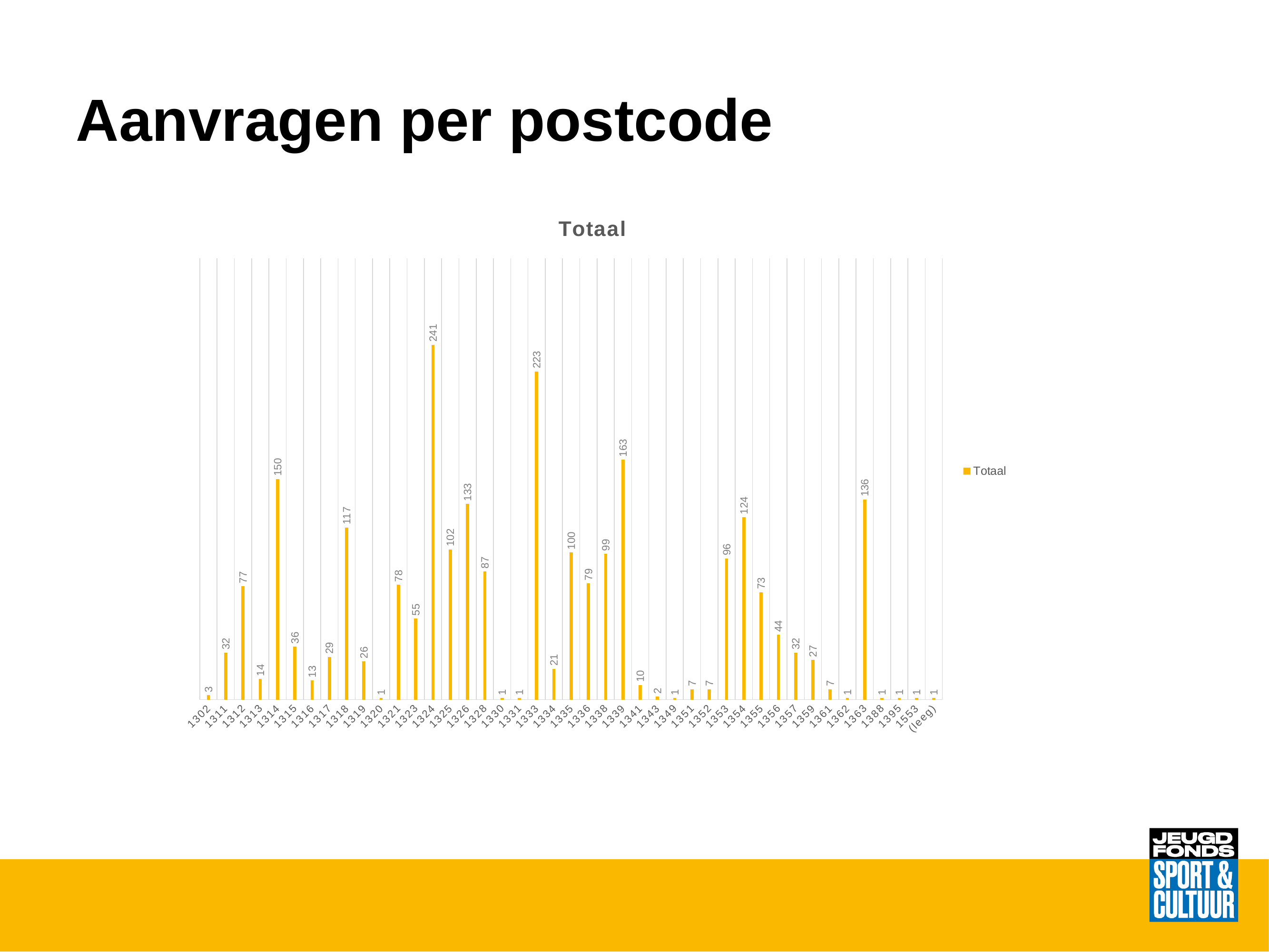
What kind of chart is shown on the slide? Bar chart Which postcode has the highest value? 1324 What is the value for postcode 1363? 136 Which has a larger value, postcode 1354 or postcode 1353? 1354 What is the title of the chart? Totaal How many postcode categories are shown on the x axis? 43 What is the difference between the values for postcodes 1324 and 1333? 18 Which has a larger value, postcode 1339 or postcode 1314? 1339 What is the value for postcode 1341? 10 What is the difference between the values for postcodes 1326 and 1325? 31 What is the value for postcode 1314? 150 How many series does the legend list? 1